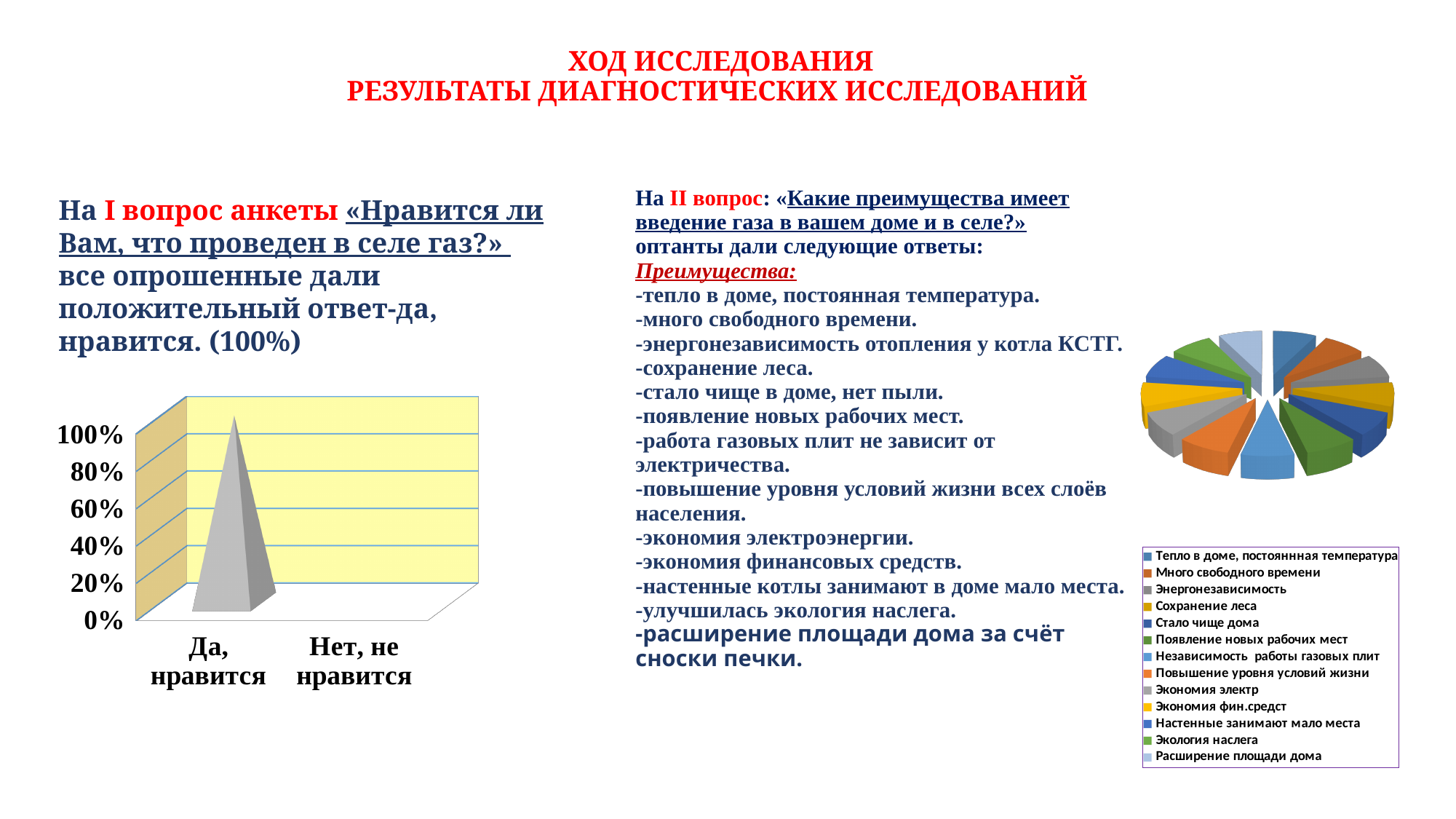
In the chart on the left, how many categories are shown on the x axis? 2 In the chart on the left, which category has the highest value? Да, нравится How many entries does the legend of the pie chart on the right list? 13 In the chart on the left, is the value for "Да, нравится" greater or less than 80%? greater In the legend of the pie chart on the right, what is the first entry? Тепло в доме, постояннная температура In the chart on the left, which category has the lowest value? Нет, не нравится What kind of chart is the chart on the right of the slide? pie chart In the chart on the left, which is larger: the value for "Да, нравится" or the value for "Нет, не нравится"? Да, нравится In the chart on the left, what is the value for "Да, нравится"? 100% What kind of chart is the chart on the left of the slide? bar chart In the chart on the left, is the value for "Нет, не нравится" greater or less than 20%? less In the legend of the pie chart on the right, what is the last entry? Расширение площади дома